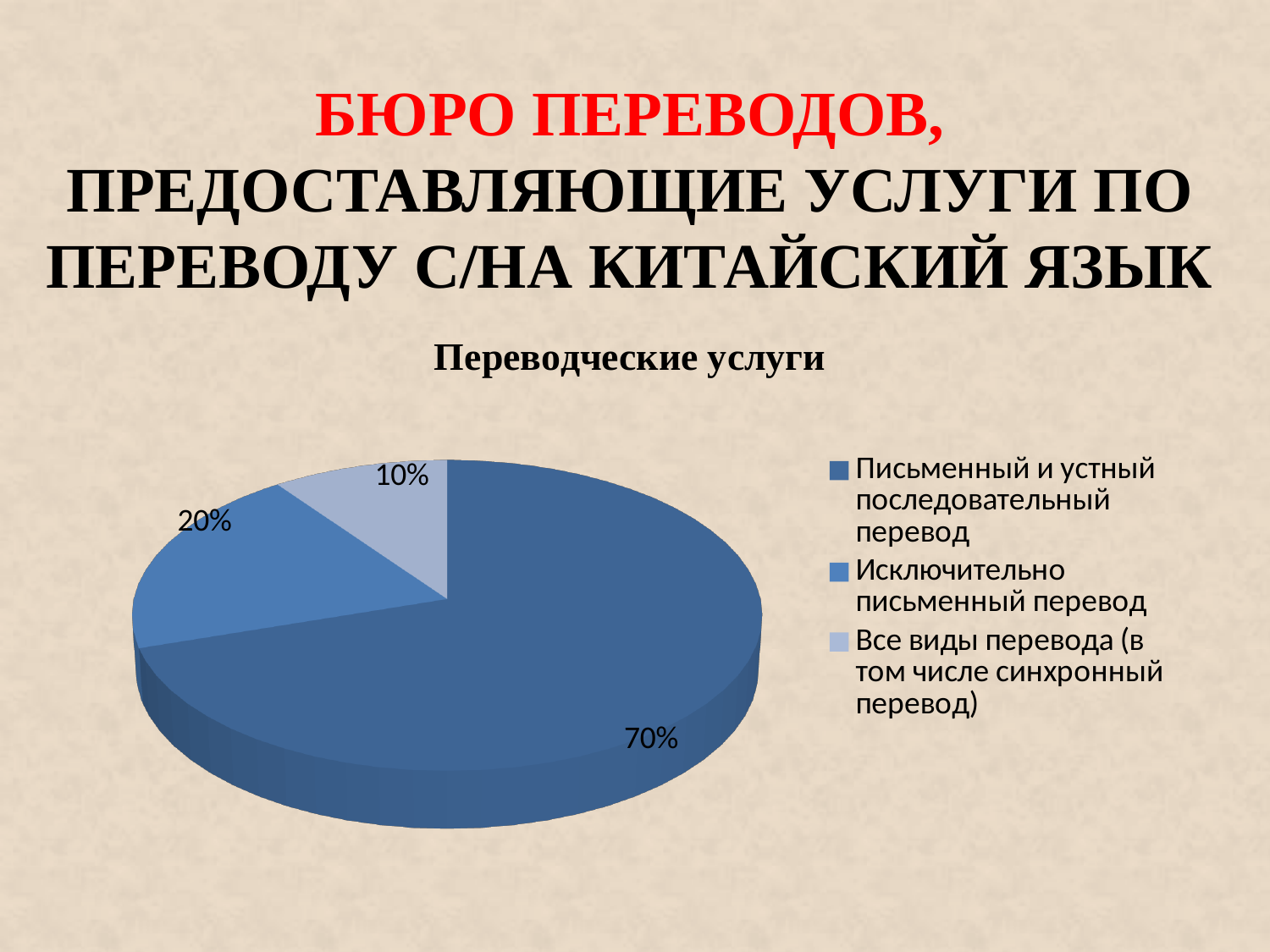
What is the combined share of 'Исключительно письменный перевод' and 'Все виды перевода (в том числе синхронный перевод)'? 30% What kind of chart is shown on the slide? Pie chart Which category has the smallest slice of the pie? Все виды перевода (в том числе синхронный перевод) Which category has the largest slice of the pie? Письменный и устный последовательный перевод What is the difference between the shares of 'Письменный и устный последовательный перевод' and 'Исключительно письменный перевод'? 50% Which is larger: the share of 'Исключительно письменный перевод' or the share of 'Все виды перевода (в том числе синхронный перевод)'? Исключительно письменный перевод How many categories does the pie chart show? 3 How many entries does the legend list? 3 What share of the pie is 'Исключительно письменный перевод'? 20% What share of the pie is 'Все виды перевода (в том числе синхронный перевод)'? 10% What share of the pie is 'Письменный и устный последовательный перевод'? 70% What is the title of the chart? Переводческие услуги